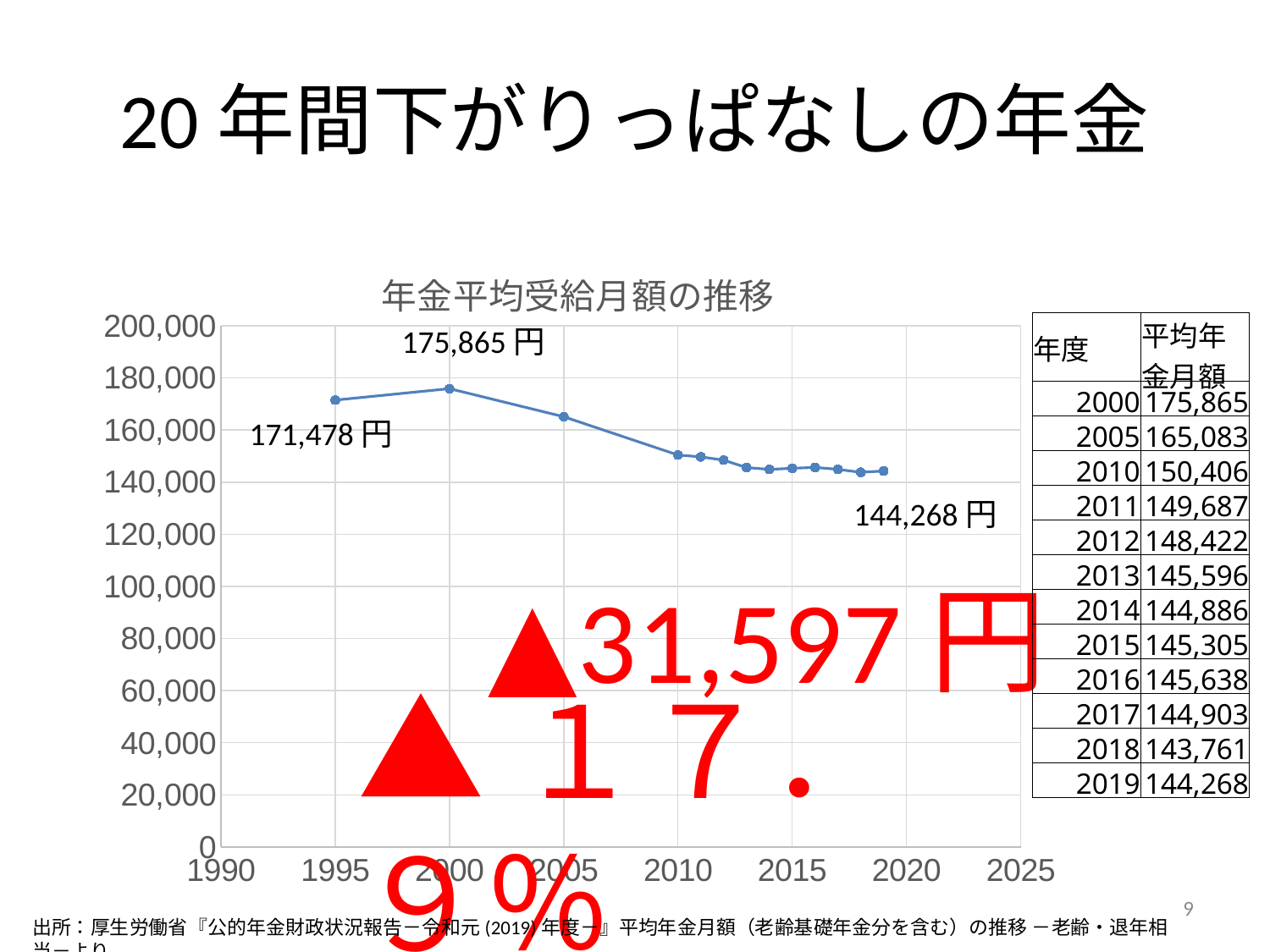
What is the difference between the 2000 value and the 1995 value on the chart? 4,387 円 Which year has the larger value, 1995 or 2019? 1995 What kind of chart is shown on the slide? line chart What is the average monthly pension value labelled for 1995 on the chart? 171,478 円 What is the average monthly pension value labelled for 2019 on the chart? 144,268 円 Is the value for 2005 greater or less than 160,000? greater What is the difference between the 2000 value and the 2019 value on the chart? 31,597 円 What is the title of the chart? 年金平均受給月額の推移 What is the average monthly pension value labelled for 2000 on the chart? 175,865 円 Is the value for 2010 greater or less than 160,000? less In which year does the line reach its highest value? 2000 Does the line generally rise or fall from 2000 to 2019? fall